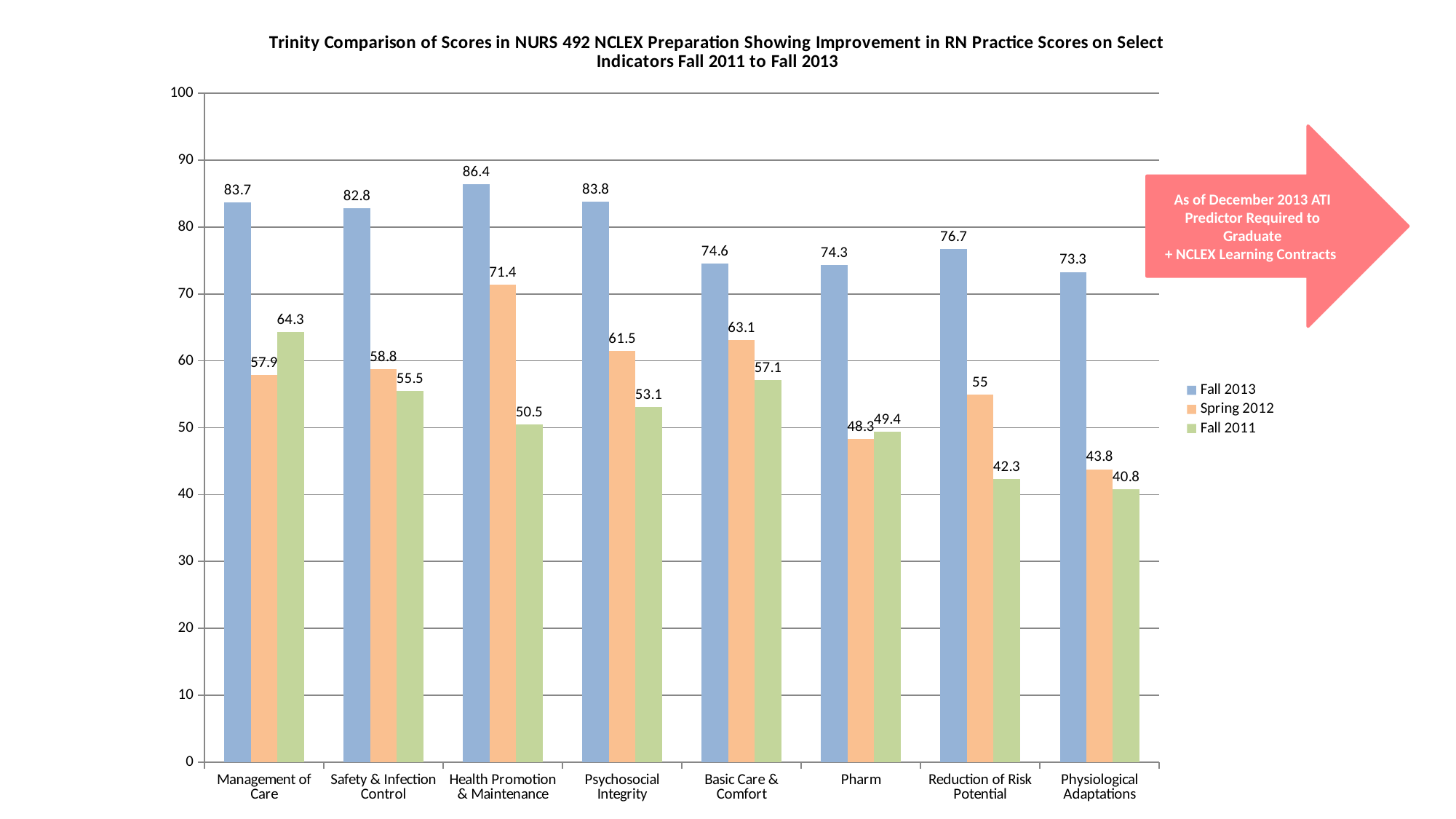
For Reduction of Risk Potential, what is the difference between the Spring 2012 and Fall 2011 scores? 12.7 What is the Spring 2012 score for Pharm? 48.3 For Management of Care, how much higher is the Fall 2013 score than the Fall 2011 score? 19.4 For Pharm, which is larger: the Spring 2012 score or the Fall 2011 score? Fall 2011 Which category has the lowest Fall 2011 score? Physiological Adaptations Which category has the highest Spring 2012 score? Health Promotion & Maintenance What is the Fall 2011 score for Physiological Adaptations? 40.8 What is the Fall 2013 score for Health Promotion & Maintenance? 86.4 How many series does the legend list? 3 How many categories are shown on the x axis? 8 Which category has the highest Fall 2013 score? Health Promotion & Maintenance What kind of chart is shown on the slide? Bar chart